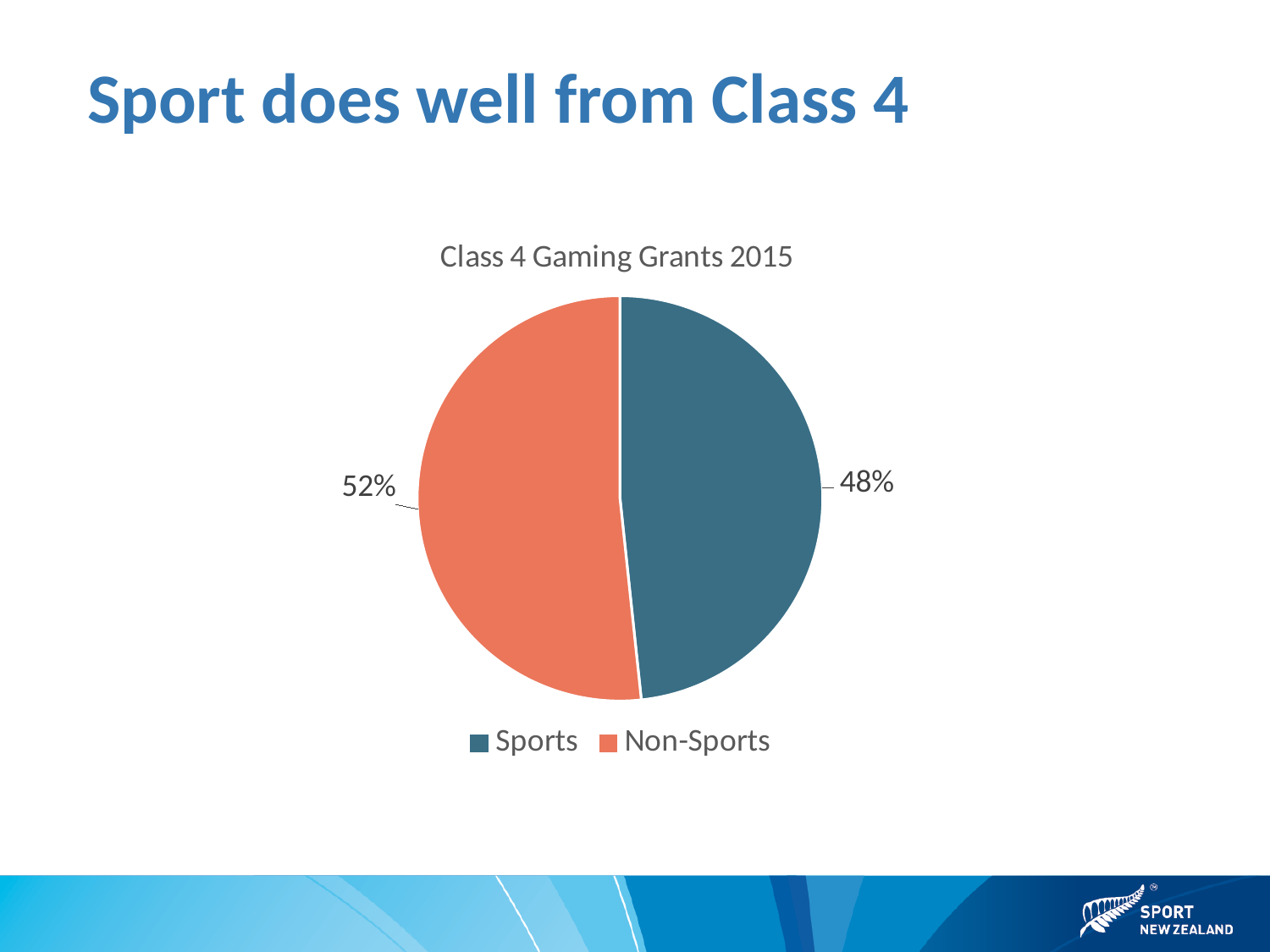
How many slices does the pie chart have? 2 Which category has the larger share of Class 4 Gaming Grants 2015? Non-Sports Which category has the smaller share of Class 4 Gaming Grants 2015? Sports Is the Sports share greater or less than 50%? less How many entries does the legend list? 2 What share of Class 4 Gaming Grants 2015 went to Non-Sports? 52% What is the difference in percentage points between the Non-Sports and Sports shares? 4 Is the Sports share larger or smaller than the Non-Sports share? smaller What is the title of the chart? Class 4 Gaming Grants 2015 What kind of chart is shown on the slide? pie chart What share of Class 4 Gaming Grants 2015 went to Sports? 48% Which colour represents Non-Sports in the chart? orange